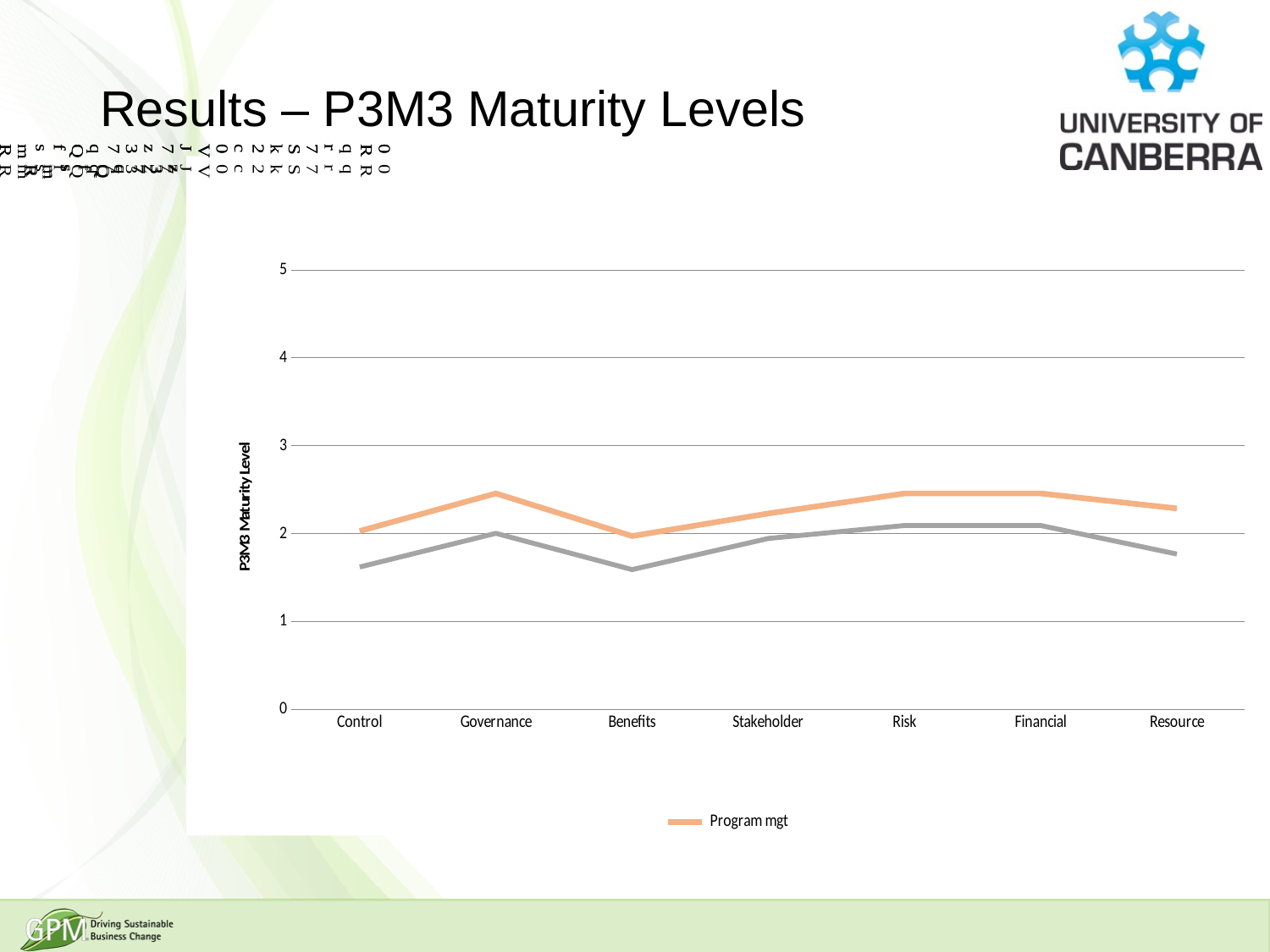
How many categories are shown along the x axis of the chart? 7 What is the title of the chart's vertical axis? P3M3 Maturity Level For the Program mgt series, which is larger: the value for Governance or the value for Benefits? Governance How many series does the chart's legend list? 1 Does the Program mgt line rise or fall from Governance to Benefits? fall Is the value of the grey line for Benefits greater or less than 2? less What kind of chart is shown on the slide? line chart Is the Program mgt value for Risk greater or less than 3? less What series name appears in the chart's legend? Program mgt Is the value of the grey line for Control greater or less than 2? less At Control, which line is higher: the Program mgt line or the grey line? Program mgt